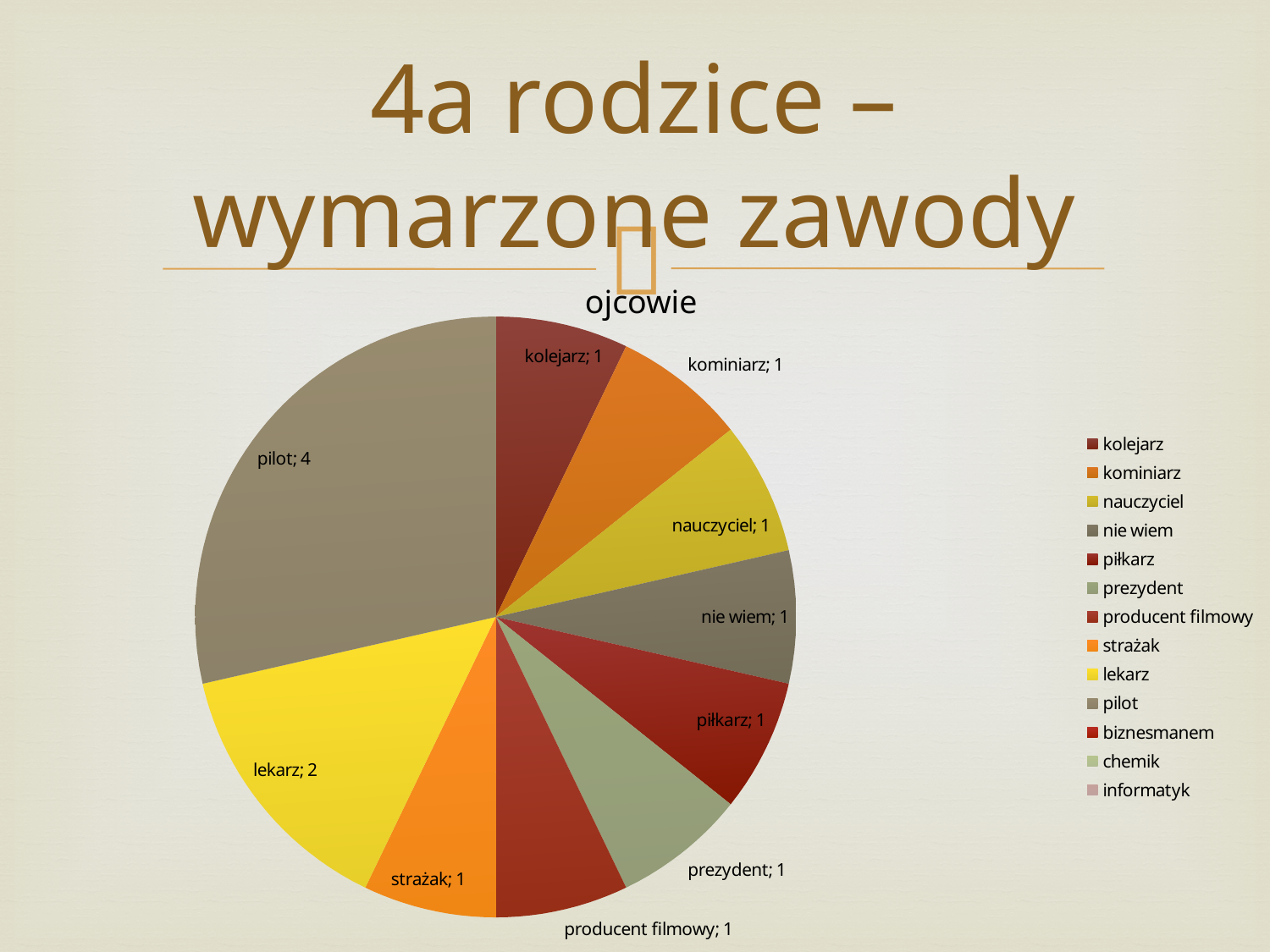
Which is larger, the value for lekarz or the value for kominiarz? lekarz What is the difference between the values for pilot and lekarz? 2 What is the value for nie wiem? 1 What is the value for pilot? 4 What is the value for strażak? 1 What is the value for lekarz? 2 What kind of chart is shown on the slide? pie chart How many entries does the legend list? 13 Which category has the largest slice? pilot What is the title of the chart? ojcowie What is the difference between the values for pilot and nauczyciel? 3 How many slices with data labels does the pie chart have? 10